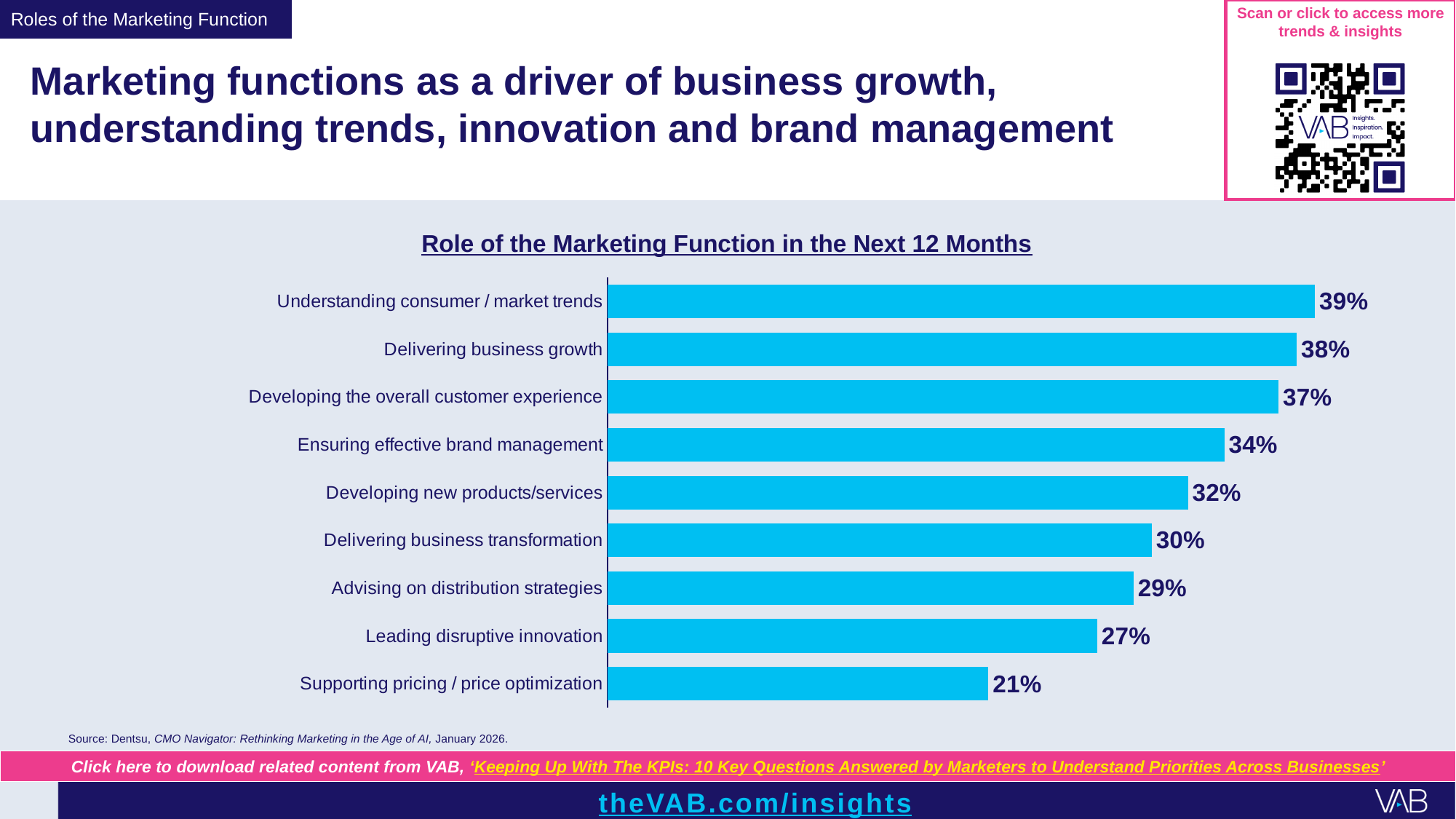
What is the value for Supporting pricing / price optimization? 21% What kind of chart is shown on the slide? Bar chart What is the difference between Developing new products/services and Supporting pricing / price optimization? 11% What is the title of the chart? Role of the Marketing Function in the Next 12 Months What is the value for Understanding consumer / market trends? 39% Which category has the lowest value? Supporting pricing / price optimization Which category has the highest value? Understanding consumer / market trends Which is larger: Delivering business transformation or Advising on distribution strategies? Delivering business transformation What is the value for Developing the overall customer experience? 37% What is the difference between Delivering business growth and Leading disruptive innovation? 11% How many categories are shown in the chart? 9 What is the value for Ensuring effective brand management? 34%